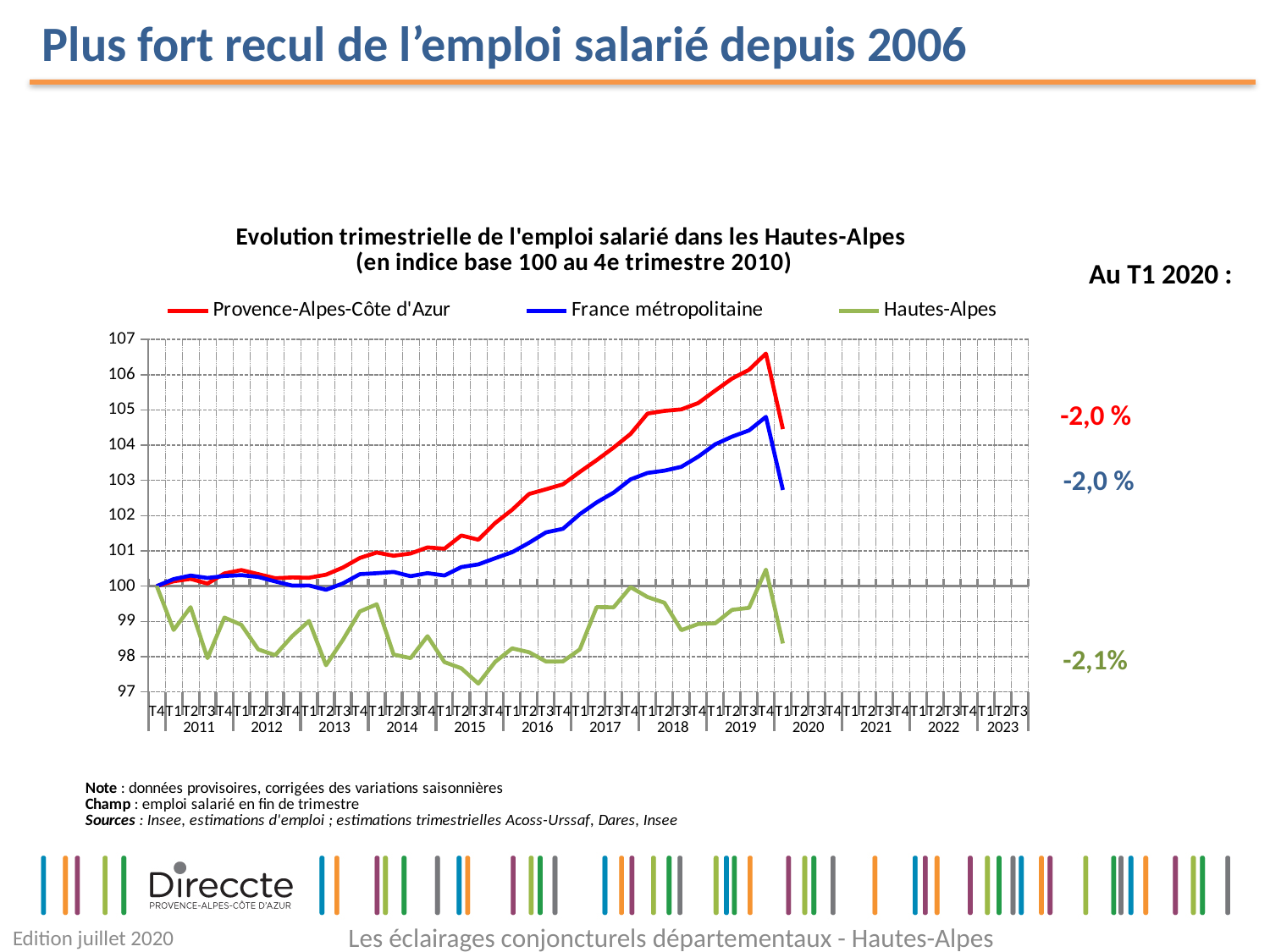
Does the Provence-Alpes-Côte d'Azur line rise or fall between 2013 and T4 2019? rise At T4 2019, which is higher: Provence-Alpes-Côte d'Azur or France métropolitaine? Provence-Alpes-Côte d'Azur Is the value for France métropolitaine at T1 2020 greater or less than 103? less Is the value for Provence-Alpes-Côte d'Azur at T4 2019 greater or less than 106? greater According to the annotation next to the chart, what is the change for Hautes-Alpes at T1 2020? -2,1% Which series are listed in the chart legend? Provence-Alpes-Côte d'Azur, France métropolitaine, Hautes-Alpes What is the title of the chart? Evolution trimestrielle de l'emploi salarié dans les Hautes-Alpes (en indice base 100 au 4e trimestre 2010) Which series has the lowest values across the whole period shown? Hautes-Alpes How many series does the legend of the chart list? 3 Is the value for Hautes-Alpes at T3 2015 greater or less than 98? less What type of chart is shown on the slide? line chart